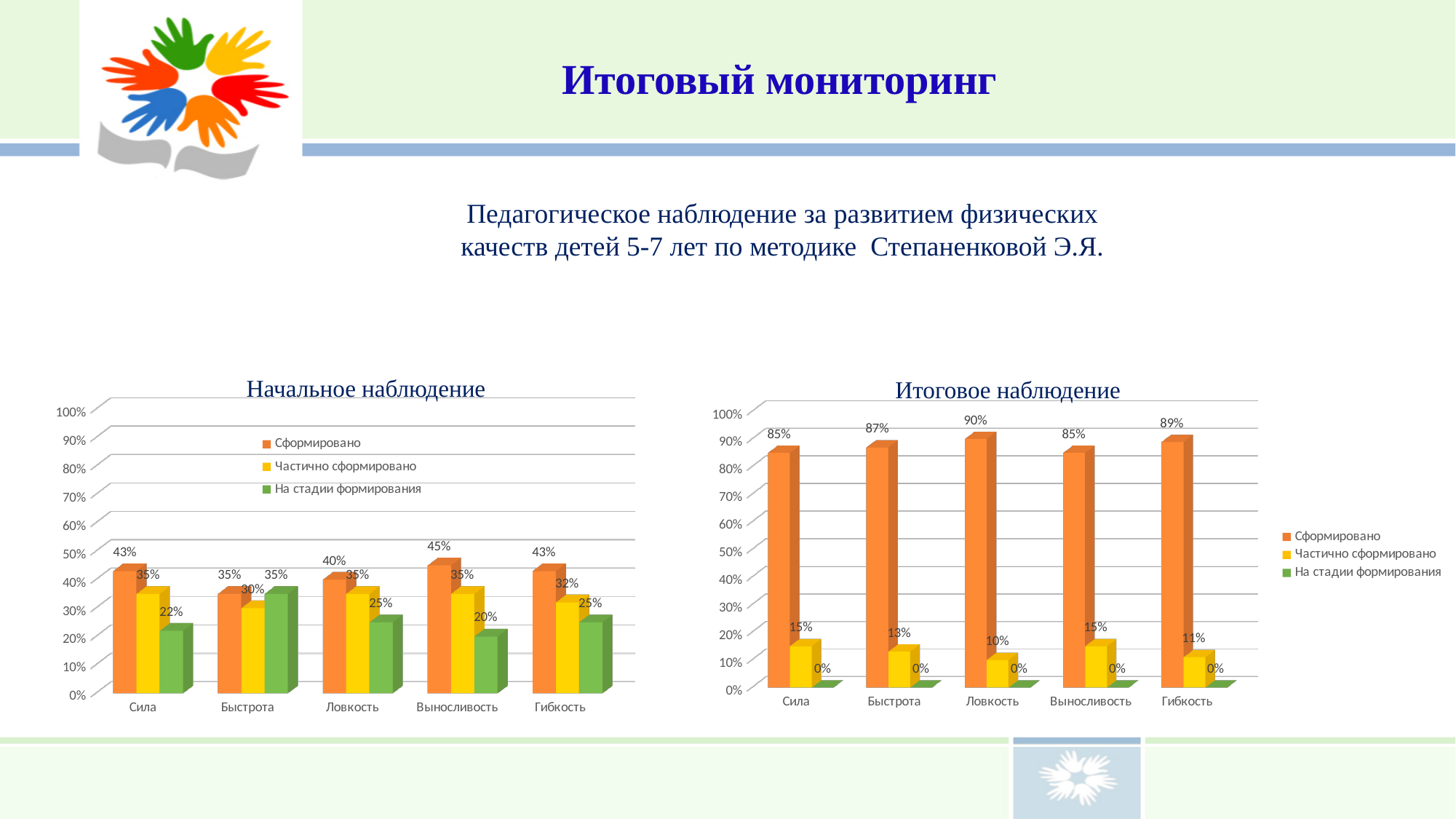
In the "Начальное наблюдение" chart, what is the value of "Частично сформировано" for Гибкость? 32% What kind of chart is the "Итоговое наблюдение" chart? Bar chart In the "Итоговое наблюдение" chart, what is the difference between the "Сформировано" values for Ловкость and Сила? 5% In the "Начальное наблюдение" chart, which is larger for Быстрота: "Сформировано" or "Частично сформировано"? Сформировано In the "Итоговое наблюдение" chart, which category has the highest "Сформировано" value? Ловкость In the "Начальное наблюдение" chart, which category has the lowest "Сформировано" value? Быстрота In the "Итоговое наблюдение" chart, is the "Сформировано" value for Быстрота greater or less than 80%? greater In the "Начальное наблюдение" chart, what is the value of "На стадии формирования" for Выносливость? 20% In the "Итоговое наблюдение" chart, what is the value of "На стадии формирования" for Гибкость? 0% How many categories are shown on the x axis of the "Начальное наблюдение" chart? 5 How many series does the legend of the "Итоговое наблюдение" chart list? 3 In the "Итоговое наблюдение" chart, what is the value of "Сформировано" for Ловкость? 90%